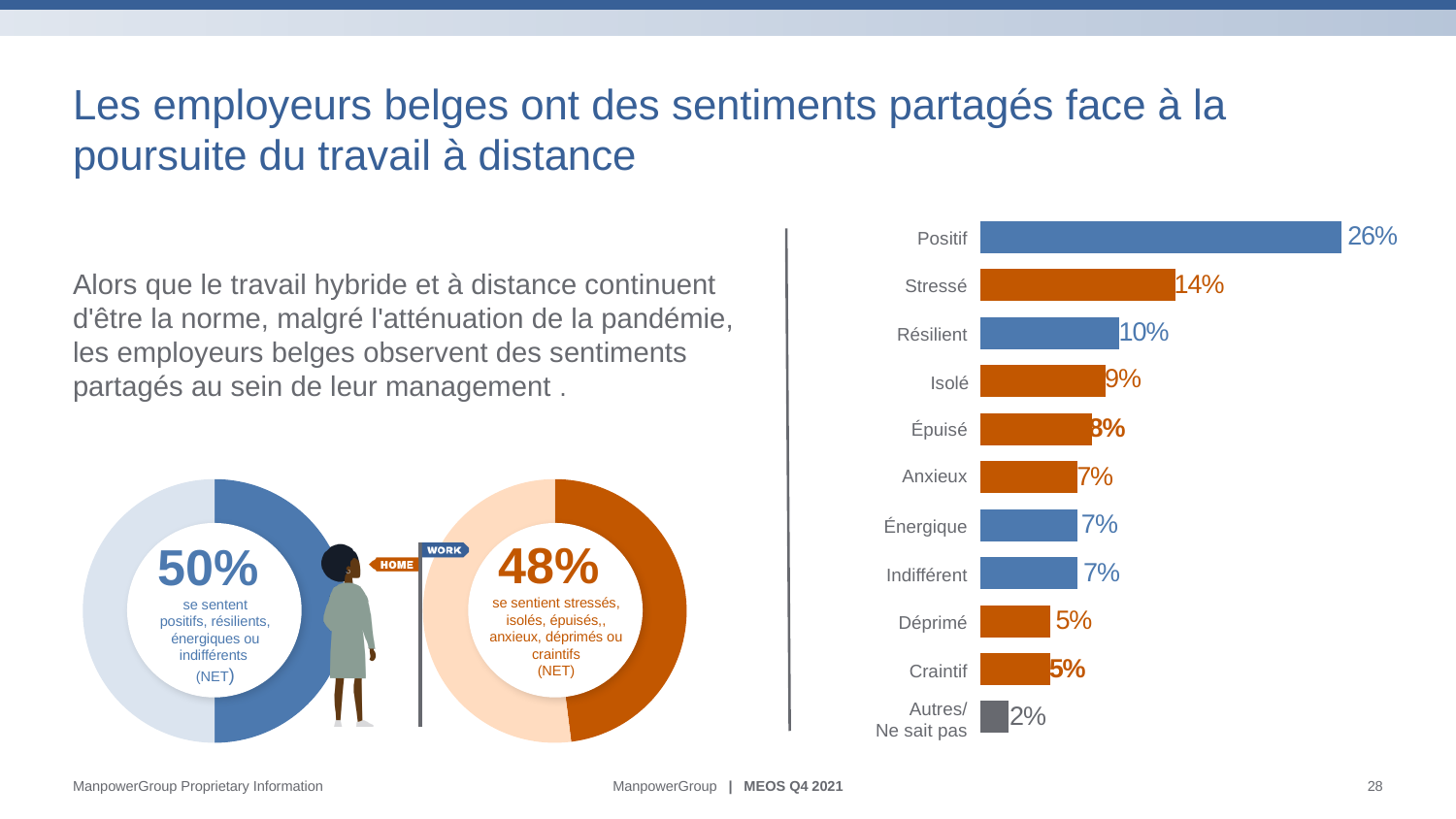
In the bar chart, what is the value for Stressé? 14% In the bar chart, what is the value for Résilient? 10% In the bar chart, which is larger, the value for Résilient or the value for Épuisé? Résilient In the left donut graphic, what percentage of employers feel positive, resilient, energetic or indifferent (NET)? 50% In the bar chart, which category has the highest value? Positif In the bar chart, what is the value for Positif? 26% How many categories are shown in the bar chart? 11 What kind of chart is shown on the right of the slide? Bar chart In the bar chart, what is the difference between the values for Isolé and Déprimé? 4% In the bar chart, which category has the lowest value? Autres/Ne sait pas In the bar chart, what is the value for Autres/Ne sait pas? 2% In the bar chart, what is the difference between the values for Positif and Stressé? 12%